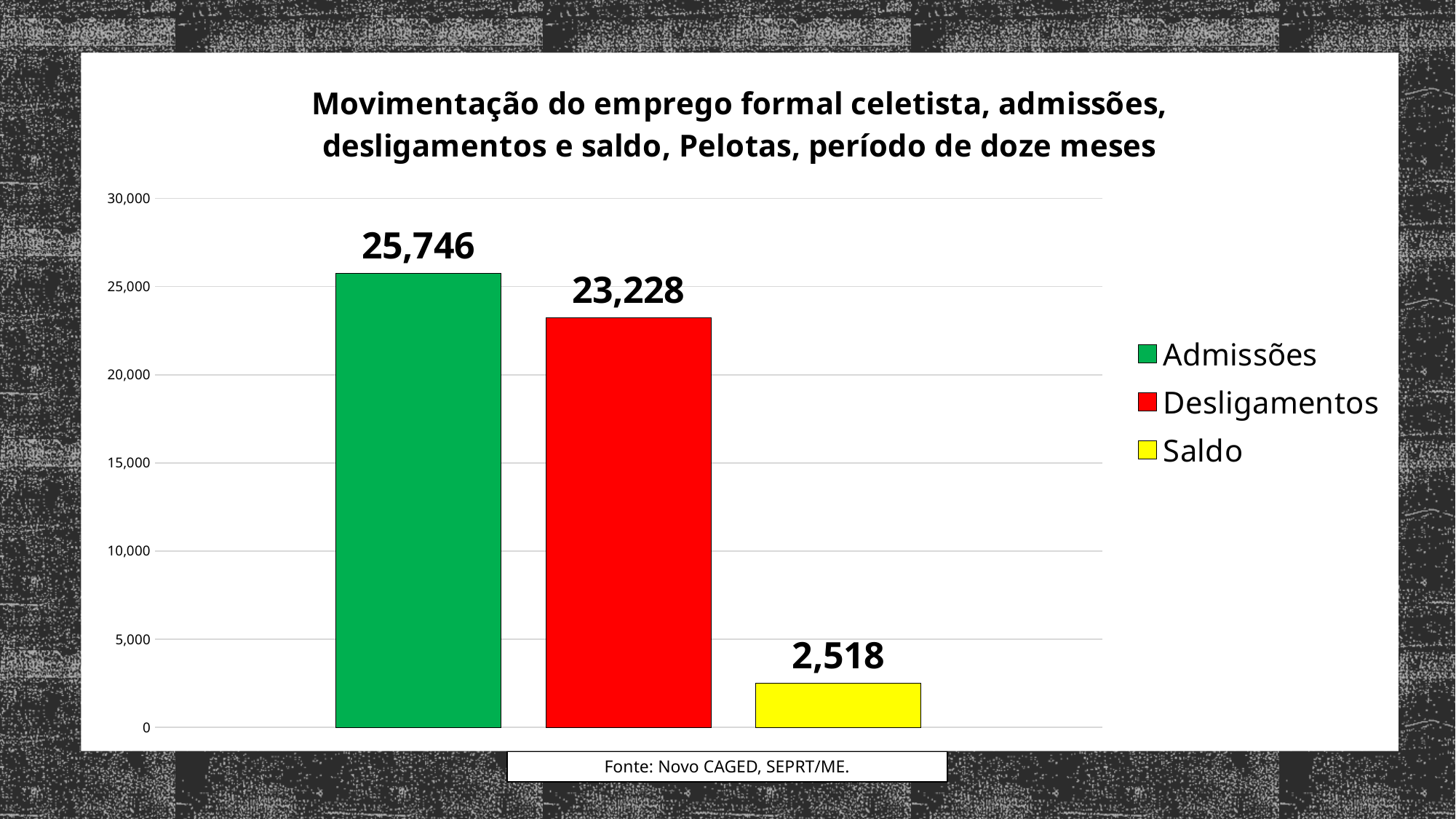
What is the value for Desligamentos? 23,228 Is the value for Desligamentos greater or less than 25,000? less What colour is the bar for Saldo? yellow What is the difference between Admissões and Desligamentos? 2,518 Which series has the lowest value? Saldo How many series does the legend list? 3 Which is larger, Desligamentos or Saldo? Desligamentos Which series has the highest value? Admissões What kind of chart is shown on the slide? bar chart How many bars are plotted in the chart? 3 What is the value for Admissões? 25,746 What is the value for Saldo? 2,518